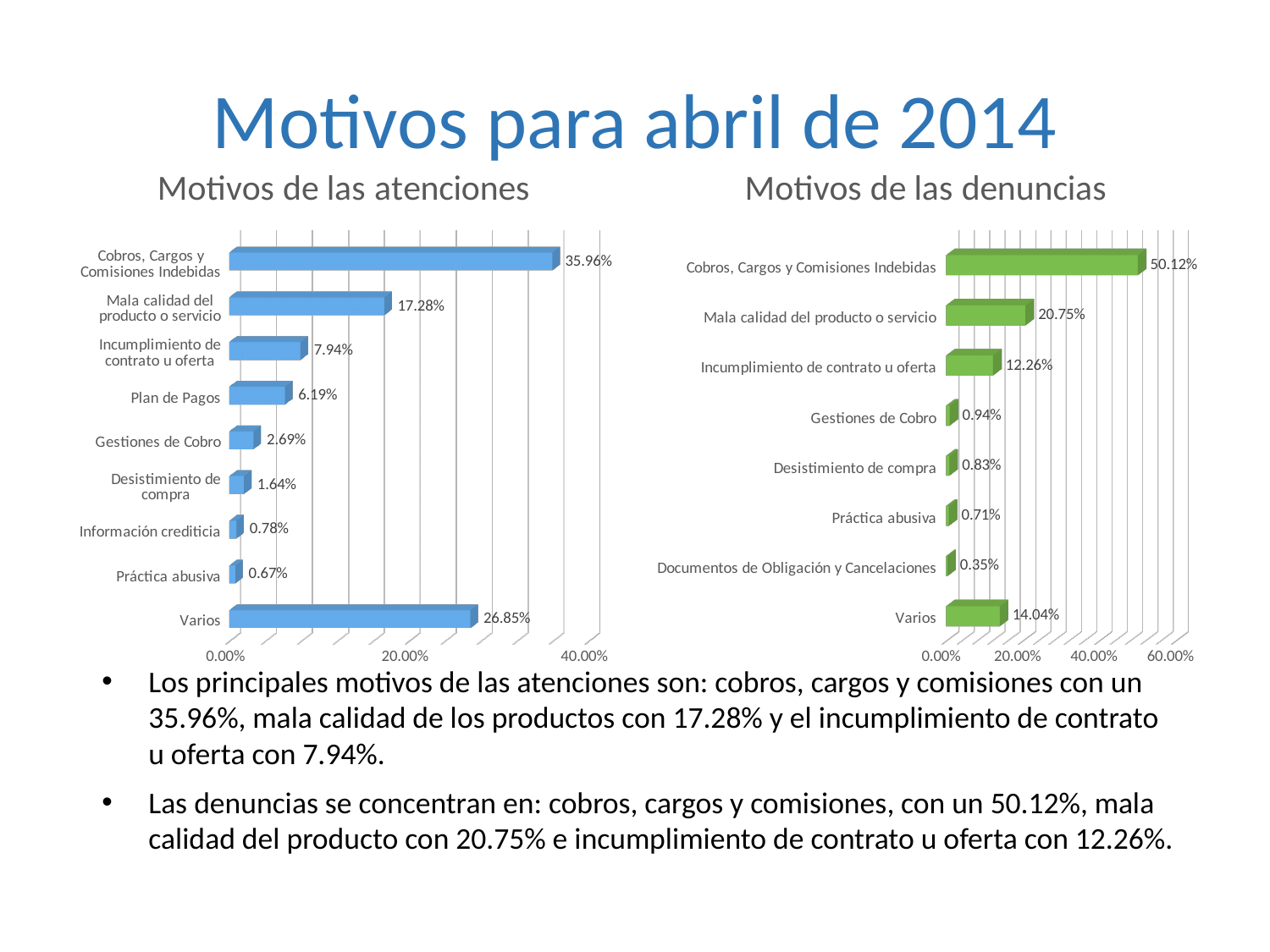
How many categories are shown in the 'Motivos de las denuncias' chart? 8 In the 'Motivos de las atenciones' chart, what is the value for Plan de Pagos? 6.19% In the 'Motivos de las atenciones' chart, which category has the highest value? Cobros, Cargos y Comisiones Indebidas In the 'Motivos de las atenciones' chart, what is the difference between Cobros, Cargos y Comisiones Indebidas and Varios? 9.11% What kind of chart is 'Motivos de las denuncias'? Bar chart In the 'Motivos de las denuncias' chart, which category has the lowest value? Documentos de Obligación y Cancelaciones In the 'Motivos de las denuncias' chart, which is larger: Mala calidad del producto o servicio or Varios? Mala calidad del producto o servicio What colour are the bars in the 'Motivos de las denuncias' chart? Green How many categories are shown in the 'Motivos de las atenciones' chart? 9 In the 'Motivos de las atenciones' chart, what is the value for Información crediticia? 0.78% In the 'Motivos de las denuncias' chart, is the value for Cobros, Cargos y Comisiones Indebidas greater or less than 40.00%? greater In the 'Motivos de las denuncias' chart, what is the value for Incumplimiento de contrato u oferta? 12.26%